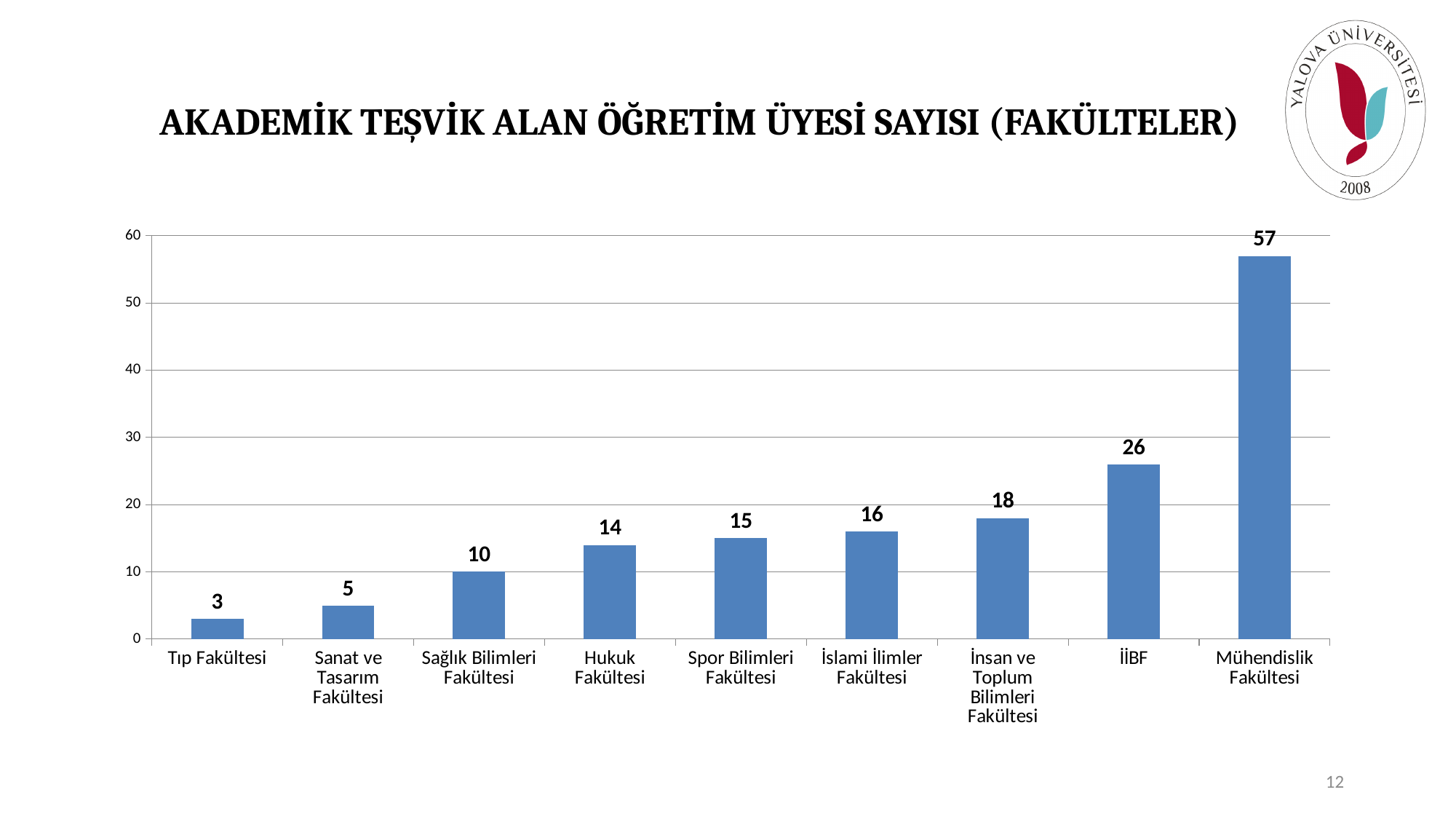
Do the values rise or fall from left to right along the x axis? rise What is the value for Mühendislik Fakültesi? 57 Which faculty has the lowest value? Tıp Fakültesi What is the value for İİBF? 26 What is the difference between the values for Mühendislik Fakültesi and İİBF? 31 What is the value for Hukuk Fakültesi? 14 Which faculty has the highest value? Mühendislik Fakültesi How many faculties are shown on the chart? 9 Which is larger, the value for Spor Bilimleri Fakültesi or the value for Sağlık Bilimleri Fakültesi? Spor Bilimleri Fakültesi Is the value for İİBF greater or less than 20? greater What kind of chart is shown on the slide? bar chart What is the difference between the values for İnsan ve Toplum Bilimleri Fakültesi and Sanat ve Tasarım Fakültesi? 13